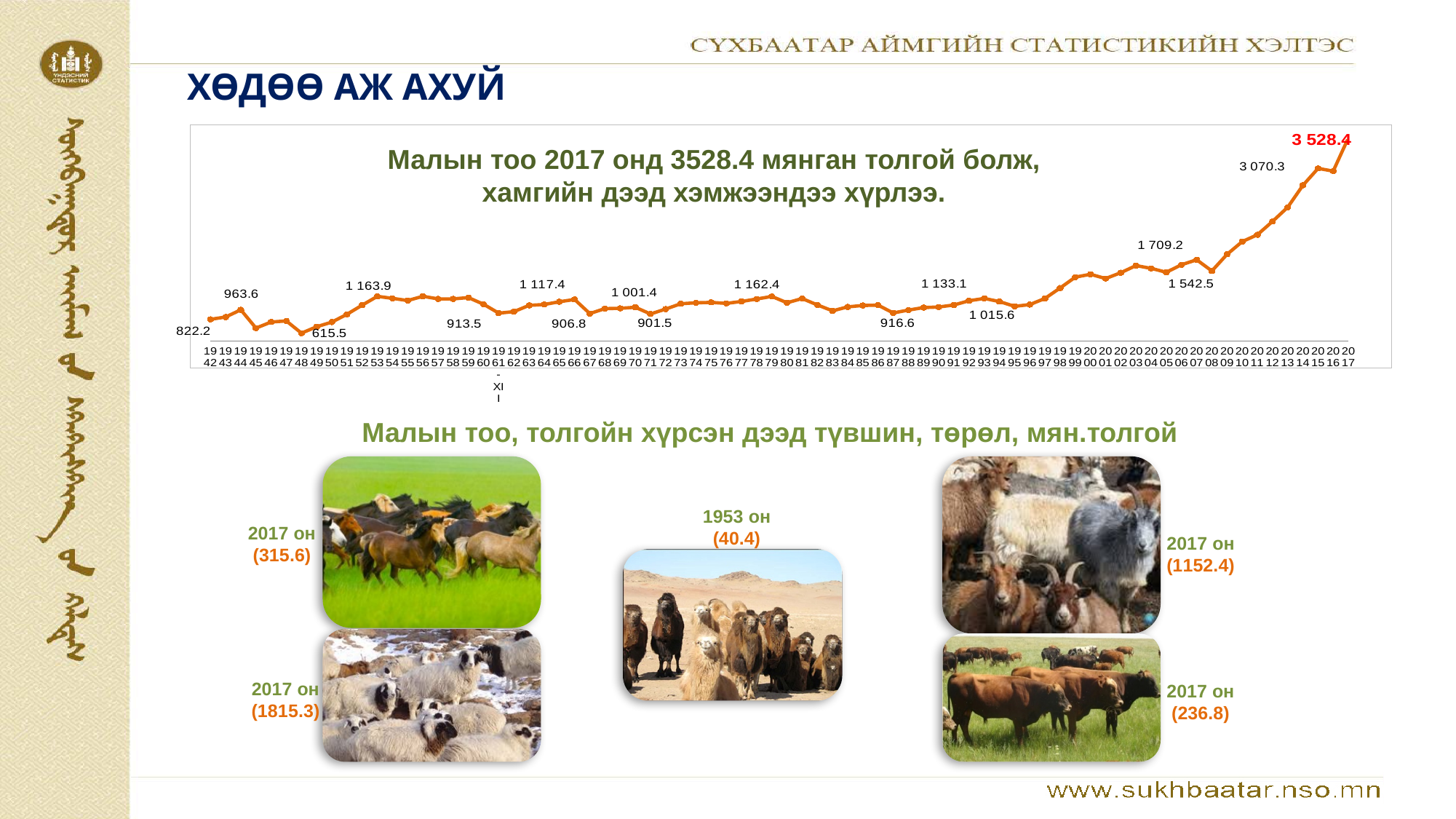
What is the difference between the labelled values 3 528.4 and 3 070.3 on the chart? 458.1 What is the difference between the 2017 value (3 528.4) and the 1942 value (822.2)? 2 706.2 Which is larger, the value labelled 1 709.2 or the value labelled 1 542.5? 1 709.2 What is the livestock count value labelled for 1942, the first year on the chart? 822.2 What type of chart is shown at the top of the slide? line chart How many data series are plotted on the line chart? 1 What is the lowest data label shown on the line chart? 615.5 Overall, do the values on the line chart rise or fall from 1942 to 2017? rise What colour is the line on the chart? orange Which is larger, the value for 1942 (822.2) or the value labelled 963.6? 963.6 Which year has the highest livestock count on the chart? 2017 What is the livestock count value labelled for 2017, the last year on the chart? 3 528.4